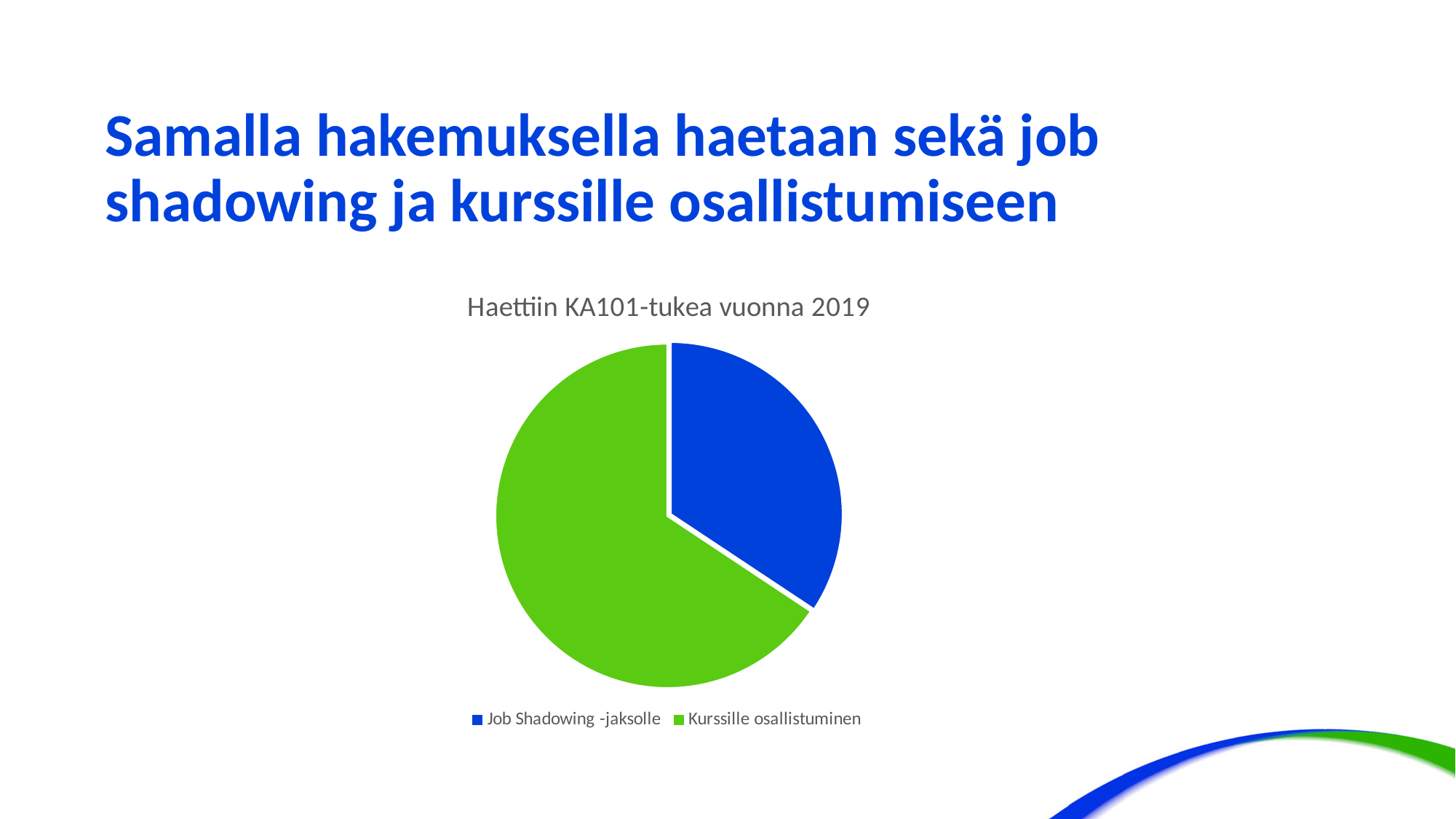
Which is larger: the slice for Job Shadowing -jaksolle or the slice for Kurssille osallistuminen? Kurssille osallistuminen Which category has the smallest slice of the pie? Job Shadowing -jaksolle Which category has the largest slice of the pie? Kurssille osallistuminen What kind of chart is shown on the slide? pie chart How many entries does the chart legend list? 2 What colour is the slice for Job Shadowing -jaksolle? blue How many slices does the pie chart have? 2 What is the title of the chart? Haettiin KA101-tukea vuonna 2019